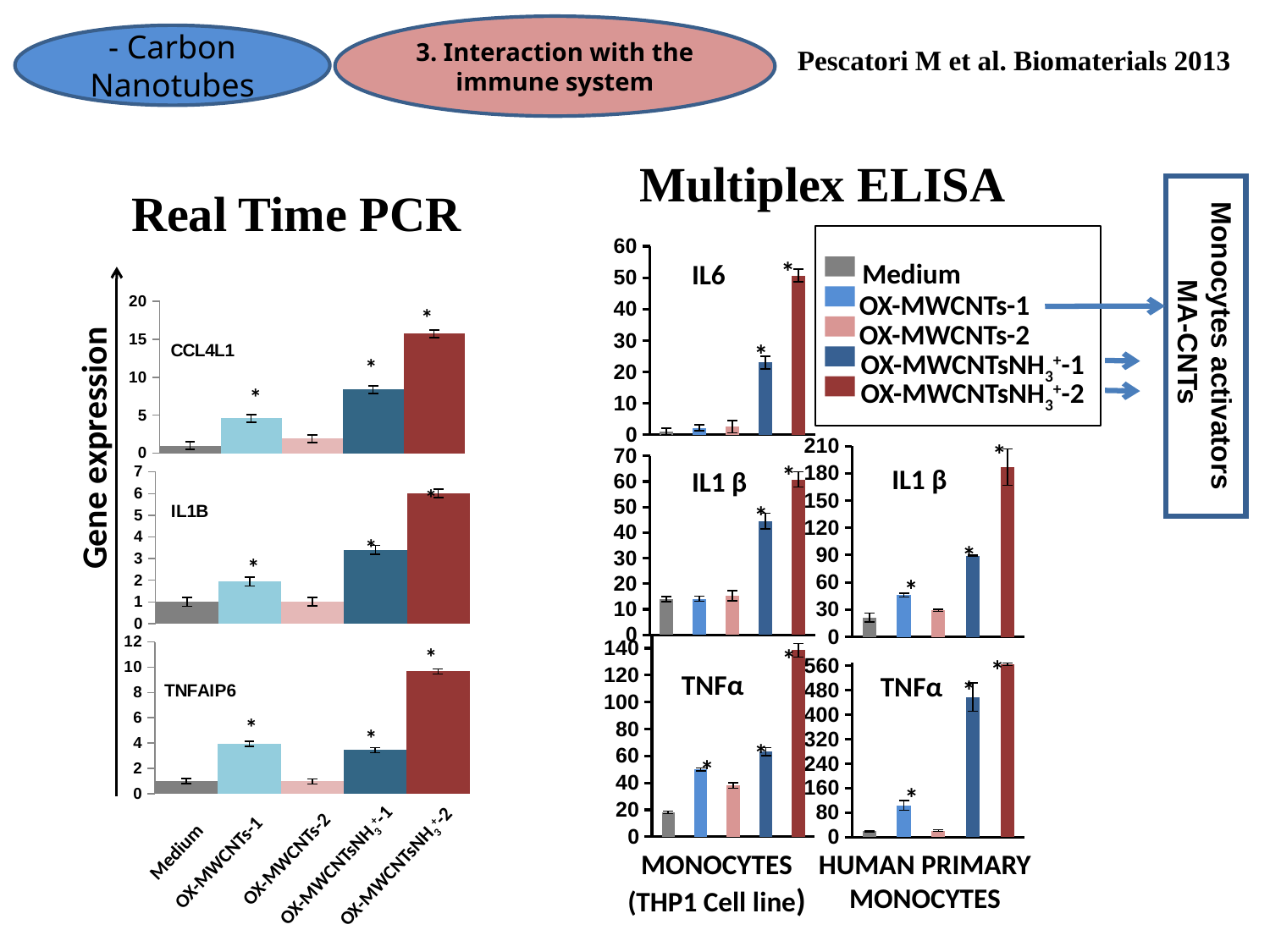
In the Real Time PCR CCL4L1 chart, is the value for OX-MWCNTsNH3+-2 greater or less than 10? greater In the Multiplex ELISA IL6 chart, which series has the highest value? OX-MWCNTsNH3+-2 How many series does the Multiplex ELISA legend list? 5 In the Real Time PCR CCL4L1 chart, which category has the highest gene expression? OX-MWCNTsNH3+-2 In the Multiplex ELISA TNFα chart for THP1 monocytes, which series has the lowest value? Medium In the Real Time PCR CCL4L1 chart, how many categories are shown on the x axis? 5 In the Real Time PCR CCL4L1 chart, is the value for OX-MWCNTs-1 greater or less than 10? less In the Multiplex ELISA IL6 chart, is the value for OX-MWCNTsNH3+-1 greater or less than 30? less In the Real Time PCR CCL4L1 chart, what kind of chart is used? bar chart In the Real Time PCR IL1B chart, which is larger, the value for OX-MWCNTs-1 or OX-MWCNTs-2? OX-MWCNTs-1